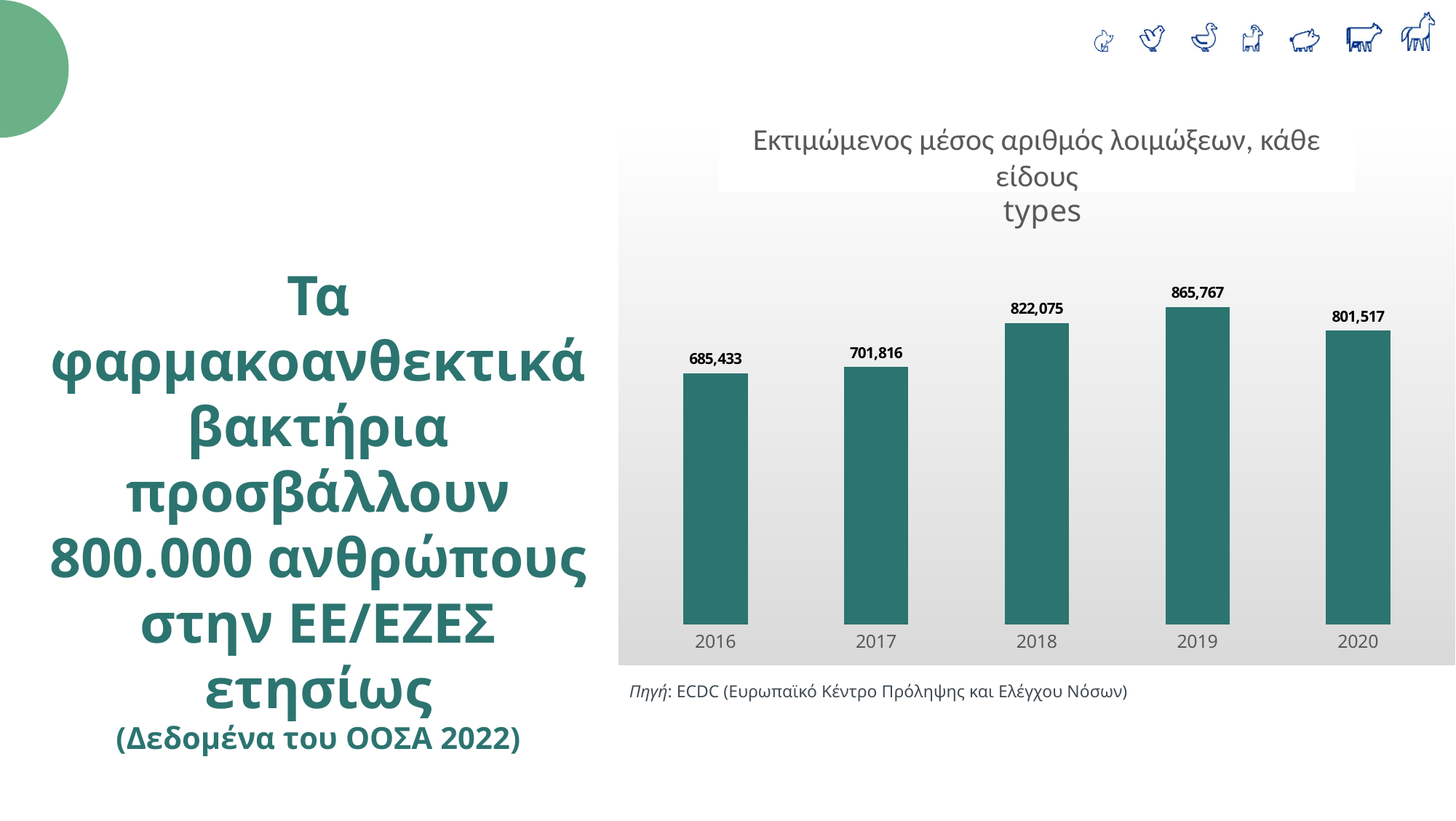
What is the value for 2020? 801,517 What is the difference between the values for 2019 and 2018? 43,692 What is the value for 2016? 685,433 How many years are shown on the x axis? 5 What is the value for 2018? 822,075 What source is cited below the chart? ECDC (Ευρωπαϊκό Κέντρο Πρόληψης και Ελέγχου Νόσων) Which is larger, the value for 2018 or the value for 2020? 2018 Do the values rise or fall from 2016 to 2019? rise Which year has the lowest value? 2016 Which year has the highest value? 2019 What is the difference between the values for 2017 and 2016? 16,383 What kind of chart is shown? bar chart